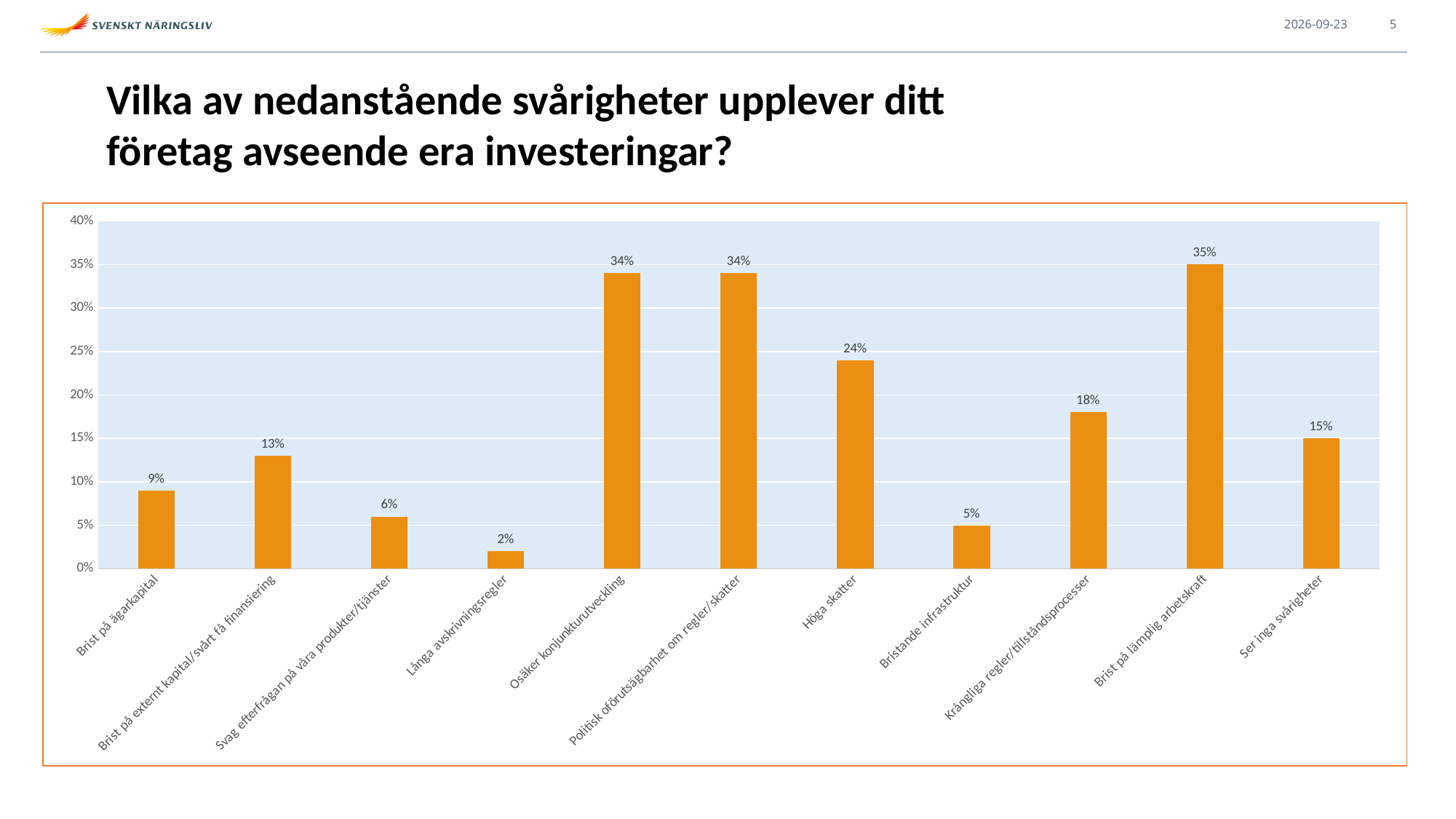
What kind of chart is shown on the slide? bar chart Which category has the lowest value? Långa avskrivningsregler What is the difference between the values for "Osäker konjunkturutveckling" and "Höga skatter"? 10% What is the value for "Höga skatter"? 24% Is the value for "Bristande infrastruktur" greater or less than 10%? less What is the value for "Ser inga svårigheter"? 15% What is the value for "Brist på externt kapital/svårt få finansiering"? 13% What is the difference between the values for "Brist på lämplig arbetskraft" and "Politisk oförutsägbarhet om regler/skatter"? 1% Which category has the highest value? Brist på lämplig arbetskraft What colour are the bars in the chart? orange Which is larger, the value for "Krångliga regler/tillståndsprocesser" or the value for "Ser inga svårigheter"? Krångliga regler/tillståndsprocesser How many categories are shown in the chart? 11